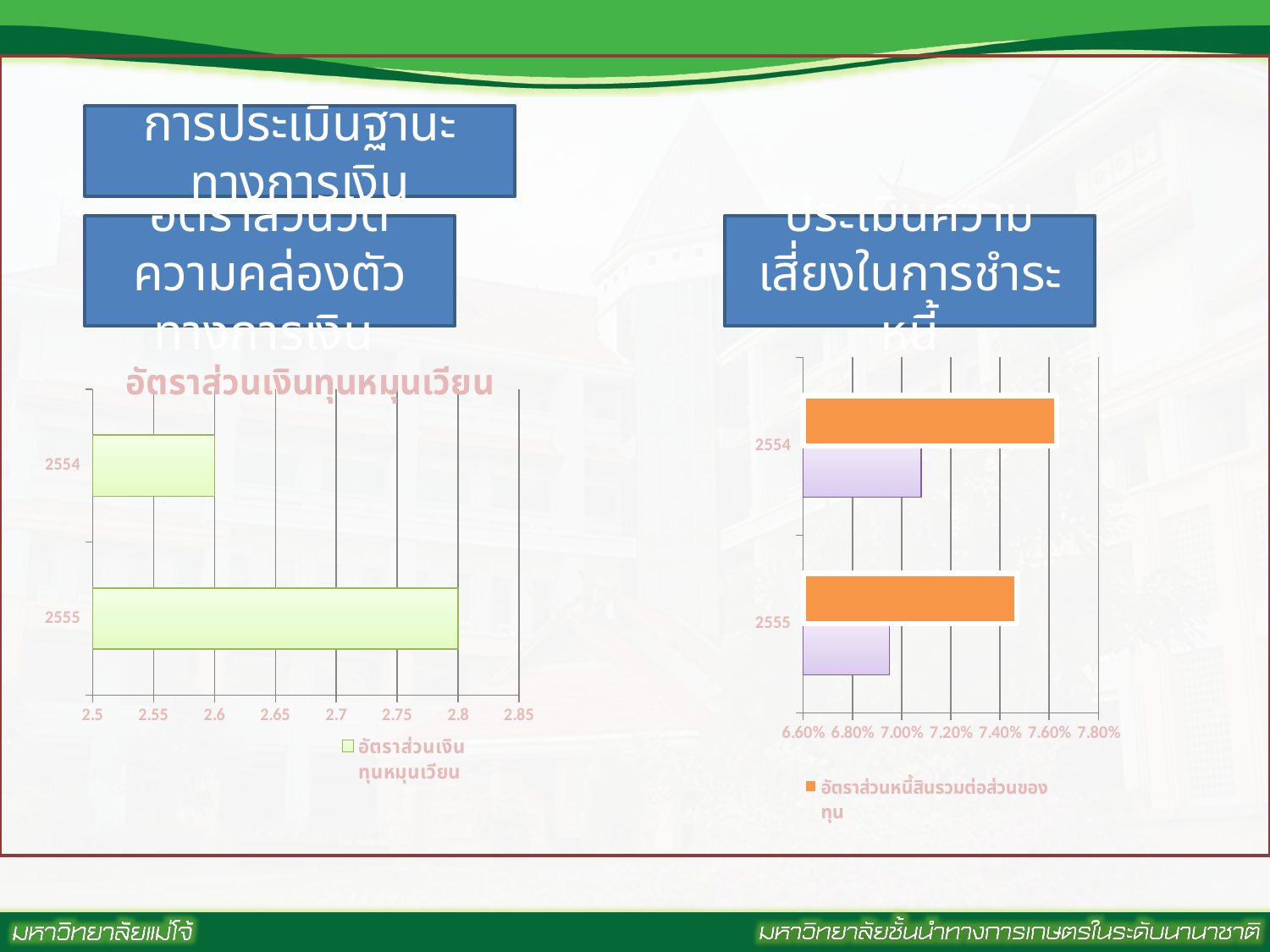
What kind of chart is the left chart titled อัตราส่วนเงินทุนหมุนเวียน? bar chart In the left chart titled อัตราส่วนเงินทุนหมุนเวียน, how many years are shown? 2 In the left chart titled อัตราส่วนเงินทุนหมุนเวียน, what is the value for 2554? 2.6 In the right chart (with the percentage axis), is the purple bar for 2555 greater or less than 7.00%? less In the right chart (with the percentage axis), what series name does the legend show for the orange bars? อัตราส่วนหนี้สินรวมต่อส่วนของทุน In the left chart titled อัตราส่วนเงินทุนหมุนเวียน, how many series does the legend list? 1 In the left chart titled อัตราส่วนเงินทุนหมุนเวียน, what is the value for 2555? 2.8 In the right chart (with the percentage axis), which year has the larger orange bar, 2554 or 2555? 2554 What kind of chart is the right chart (with the percentage axis)? bar chart In the left chart titled อัตราส่วนเงินทุนหมุนเวียน, which year has the higher value? 2555 In the right chart (with the percentage axis), is the orange bar for 2554 greater or less than 7.40%? greater In the left chart titled อัตราส่วนเงินทุนหมุนเวียน, what is the difference between the values for 2555 and 2554? 0.2